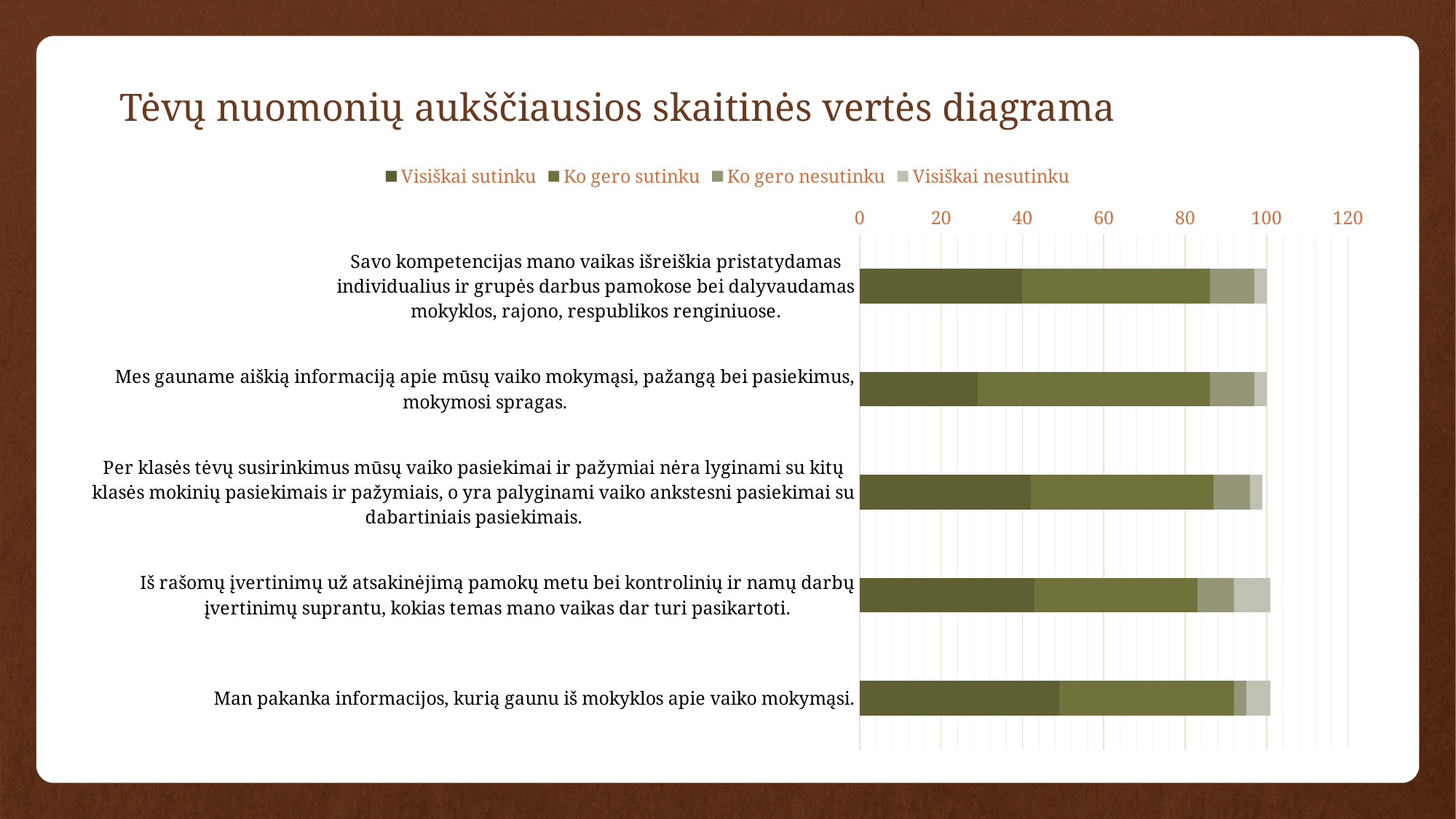
Which statement has the smallest 'Visiškai sutinku' segment? Mes gauname aiškią informaciją apie mūsų vaiko mokymąsi, pažangą bei pasiekimus, mokymosi spragas. Which series is listed first in the legend? Visiškai sutinku Which statement has the largest 'Visiškai sutinku' segment? Man pakanka informacijos, kurią gaunu iš mokyklos apie vaiko mokymąsi. Is the 'Visiškai sutinku' value for 'Iš rašomų įvertinimų už atsakinėjimą pamokų metu bei kontrolinių ir namų darbų įvertinimų suprantu, kokias temas mano vaikas dar turi pasikartoti.' greater or less than 60? less Is the 'Visiškai sutinku' value for 'Mes gauname aiškią informaciją apie mūsų vaiko mokymąsi, pažangą bei pasiekimus, mokymosi spragas.' greater or less than 40? less Which has the larger 'Visiškai sutinku' value: 'Man pakanka informacijos, kurią gaunu iš mokyklos apie vaiko mokymąsi.' or 'Mes gauname aiškią informaciją apie mūsų vaiko mokymąsi, pažangą bei pasiekimus, mokymosi spragas.'? Man pakanka informacijos, kurią gaunu iš mokyklos apie vaiko mokymąsi. What kind of chart is shown on the slide? Stacked bar chart How many series does the legend list? 4 How many categories (statements) are plotted on the chart? 5 Is the 'Visiškai sutinku' value for 'Man pakanka informacijos, kurią gaunu iš mokyklos apie vaiko mokymąsi.' greater or less than 40? greater What is the title of the chart? Tėvų nuomonių aukščiausios skaitinės vertės diagrama